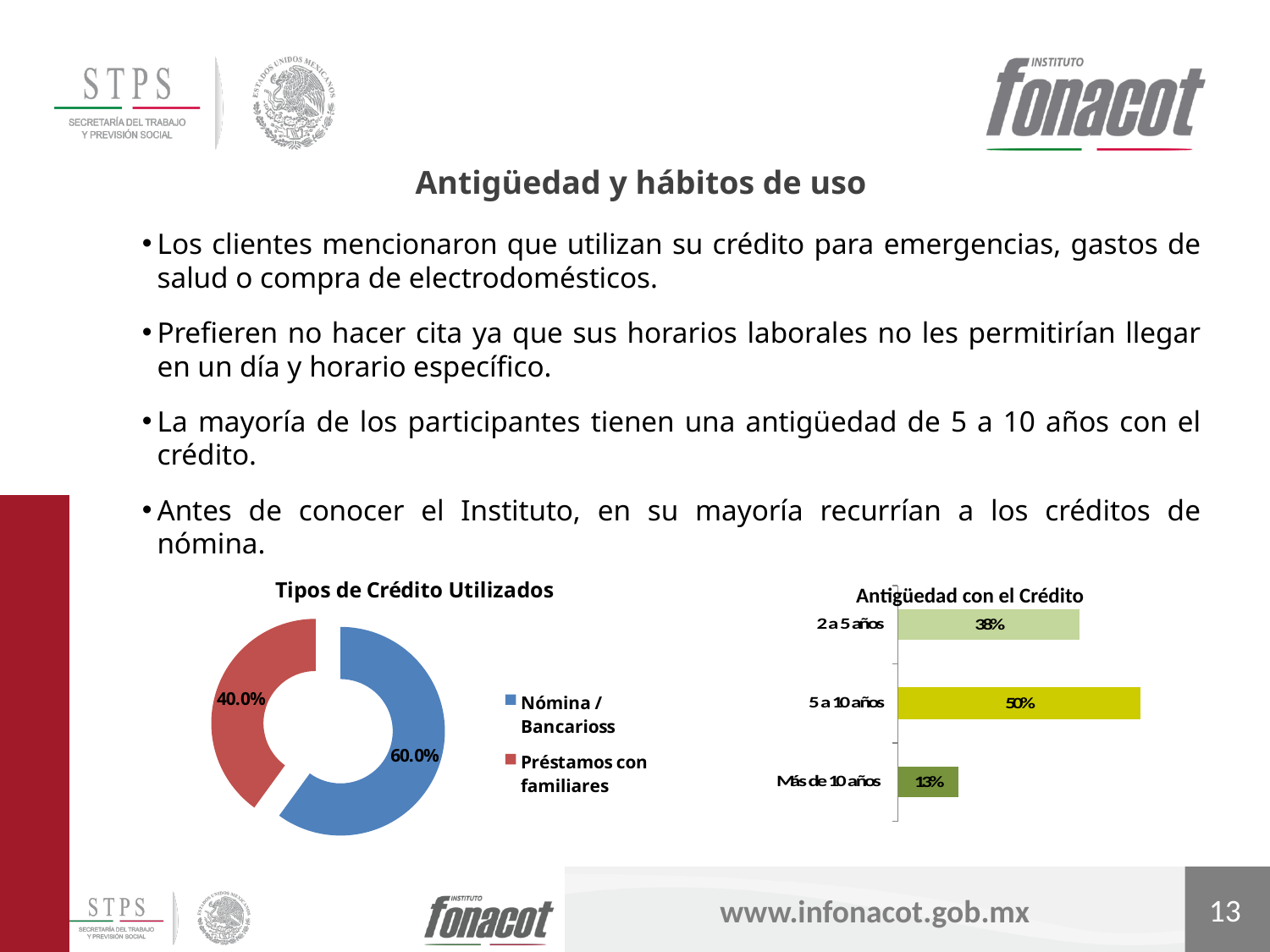
How many categories are shown in the 'Antigüedad con el Crédito' chart? 3 In the 'Tipos de Crédito Utilizados' chart, what share is shown for 'Préstamos con familiares'? 40.0% How many entries does the legend of the 'Tipos de Crédito Utilizados' chart list? 2 In the 'Tipos de Crédito Utilizados' chart, which category has the larger share? Nómina / Bancarioss What kind of chart is 'Tipos de Crédito Utilizados'? Doughnut (pie) chart In the 'Antigüedad con el Crédito' chart, what is the value for '5 a 10 años'? 50% What kind of chart is 'Antigüedad con el Crédito'? Bar chart In the 'Antigüedad con el Crédito' chart, what is the value for '2 a 5 años'? 38% In the 'Antigüedad con el Crédito' chart, what is the difference between '5 a 10 años' and 'Más de 10 años'? 37% In the 'Antigüedad con el Crédito' chart, which category has the lowest value? Más de 10 años In the 'Tipos de Crédito Utilizados' chart, what is the difference between the two shares? 20.0% In the 'Tipos de Crédito Utilizados' chart, what share is shown for 'Nómina / Bancarioss'? 60.0%